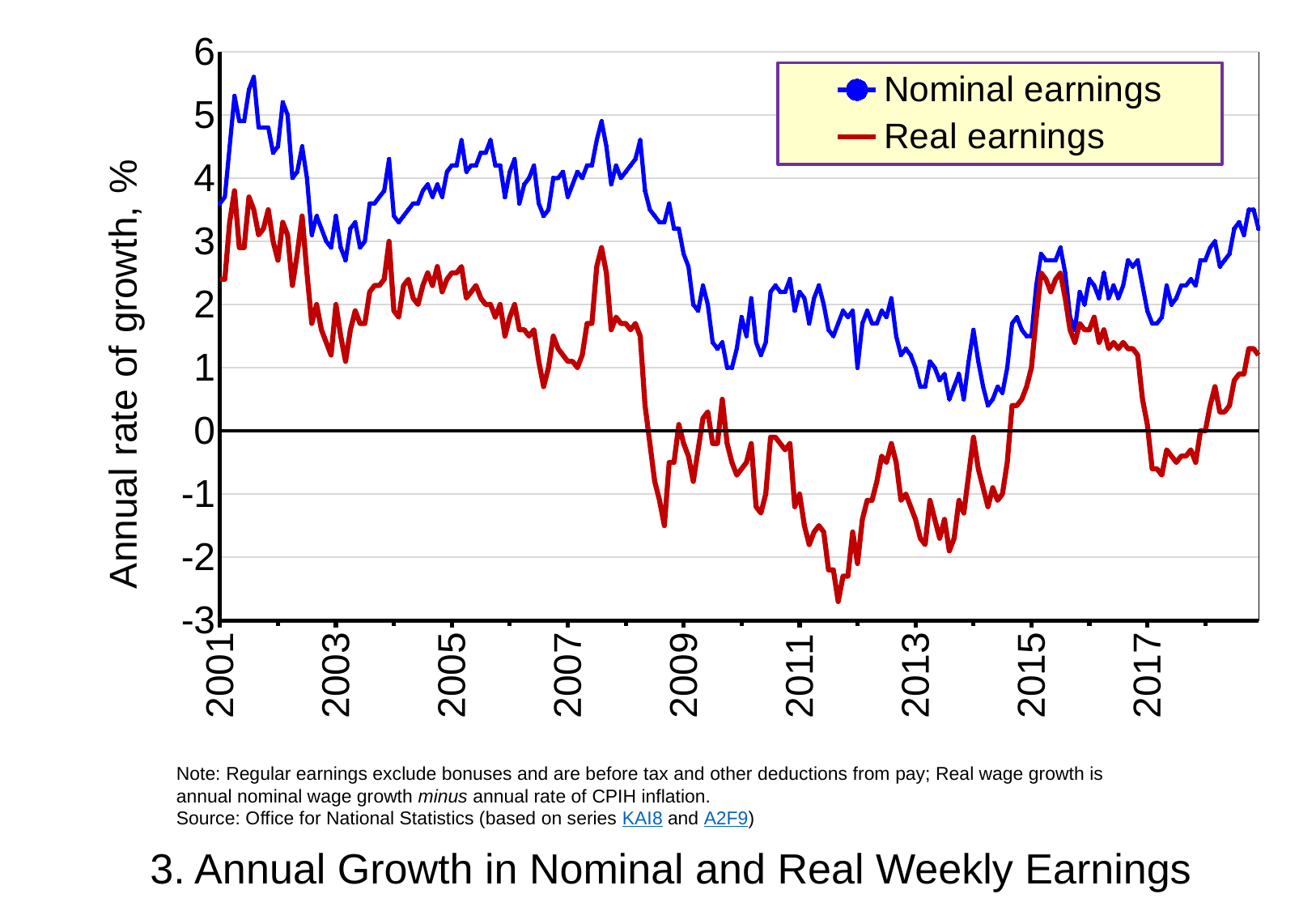
Which series reaches the highest value on the chart? Nominal earnings What is the label on the vertical axis? Annual rate of growth, % What is the title of the chart? 3. Annual Growth in Nominal and Real Weekly Earnings Does Nominal earnings rise or fall between 2007 and 2009? Fall Between which two labelled years does Real earnings reach its lowest value? 2011 and 2013 Is the value for Nominal earnings at 2001 greater or less than 3? greater Is the value for Nominal earnings at 2015 greater or less than 2? less How many series does the legend list? 2 What kind of chart is shown on the slide? Line chart At 2013, which series has the higher value, Nominal earnings or Real earnings? Nominal earnings